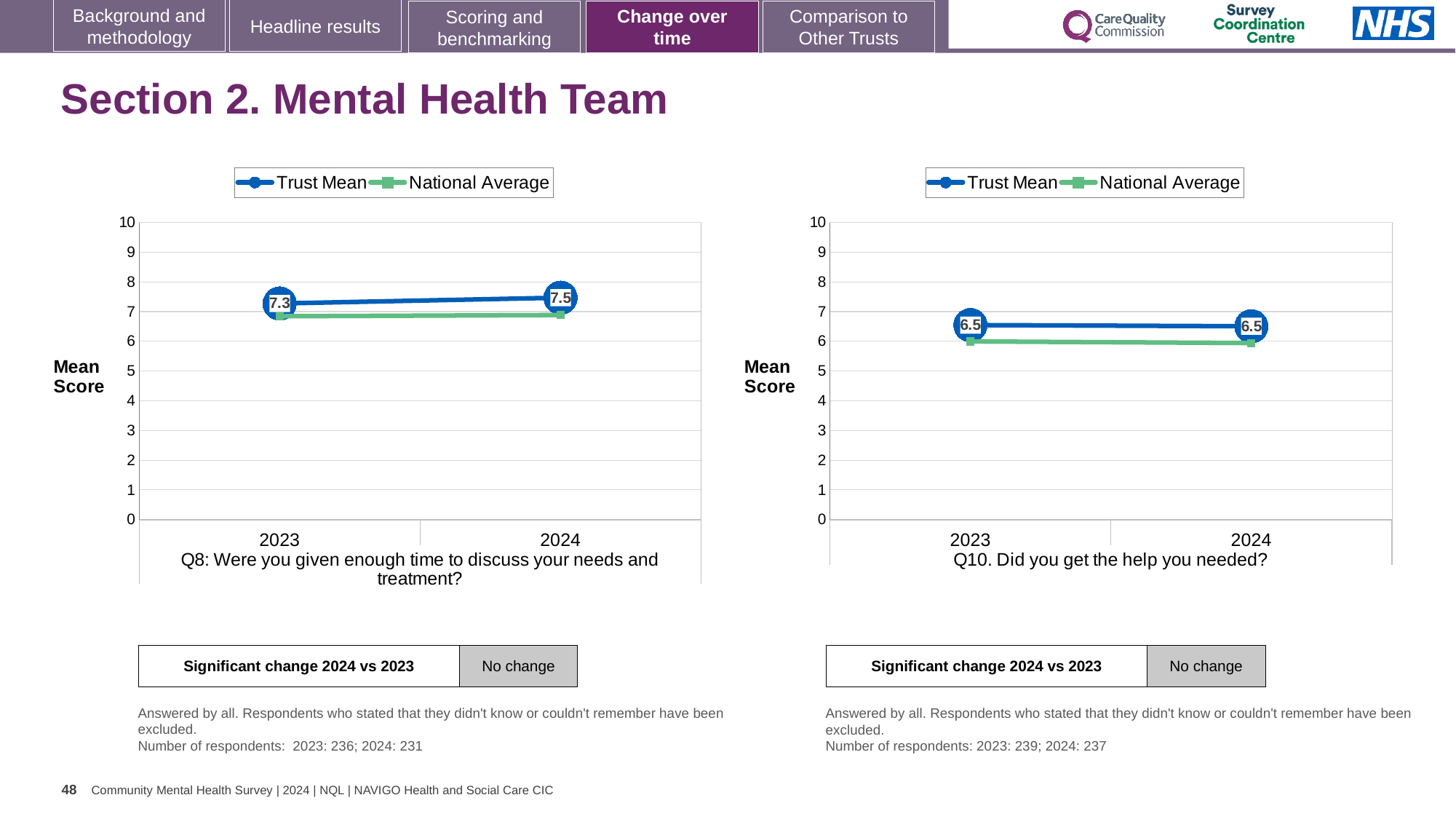
In the Q8 chart, which year has the higher Trust Mean score? 2024 In the Q8 chart, by how much did the Trust Mean change from 2023 to 2024? 0.2 In the Q8 chart, what is the Trust Mean score for 2023? 7.3 In the Q10 chart, what is the Trust Mean score for 2024? 6.5 How many years are plotted on the x axis of the Q10 chart? 2 In the Q10 chart, is the Trust Mean for 2023 greater or less than the National Average for 2023? greater In the Q10 chart, is the National Average for 2024 greater or less than 5? greater In the Q10 chart, does the Trust Mean rise, fall or stay the same from 2023 to 2024? stay the same How many series does the legend of the Q8 chart list? 2 In the Q8 chart, does the Trust Mean rise or fall from 2023 to 2024? rise What type of chart is used for Q8? line chart In the Q8 chart, what is the Trust Mean score for 2024? 7.5